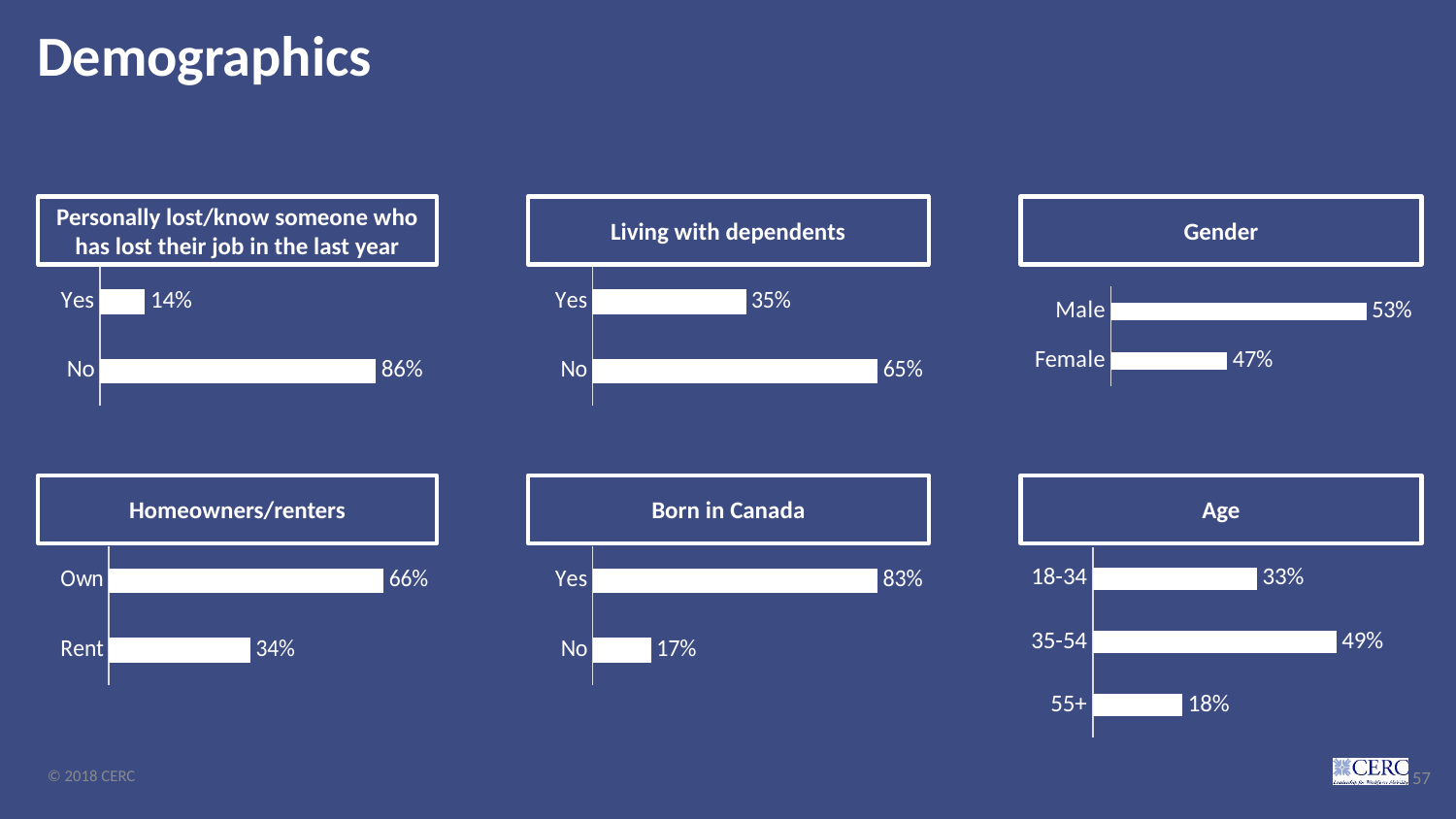
In the 'Living with dependents' chart, what is the difference between No and Yes? 30% In the 'Gender' chart, which category has the higher value? Male In the 'Living with dependents' chart, what is the value for No? 65% In the 'Born in Canada' chart, what is the value for No? 17% How many charts are shown on the slide? 6 In the 'Age' chart, which age group has the lowest value? 55+ How many categories does the 'Age' chart show? 3 In the 'Homeowners/renters' chart, what is the difference between Own and Rent? 32% In the 'Age' chart, what is the value for 35-54? 49% In the 'Born in Canada' chart, which is larger, Yes or No? Yes In the 'Personally lost/know someone who has lost their job in the last year' chart, what is the value for Yes? 14% What kind of chart is the 'Gender' chart? Bar chart